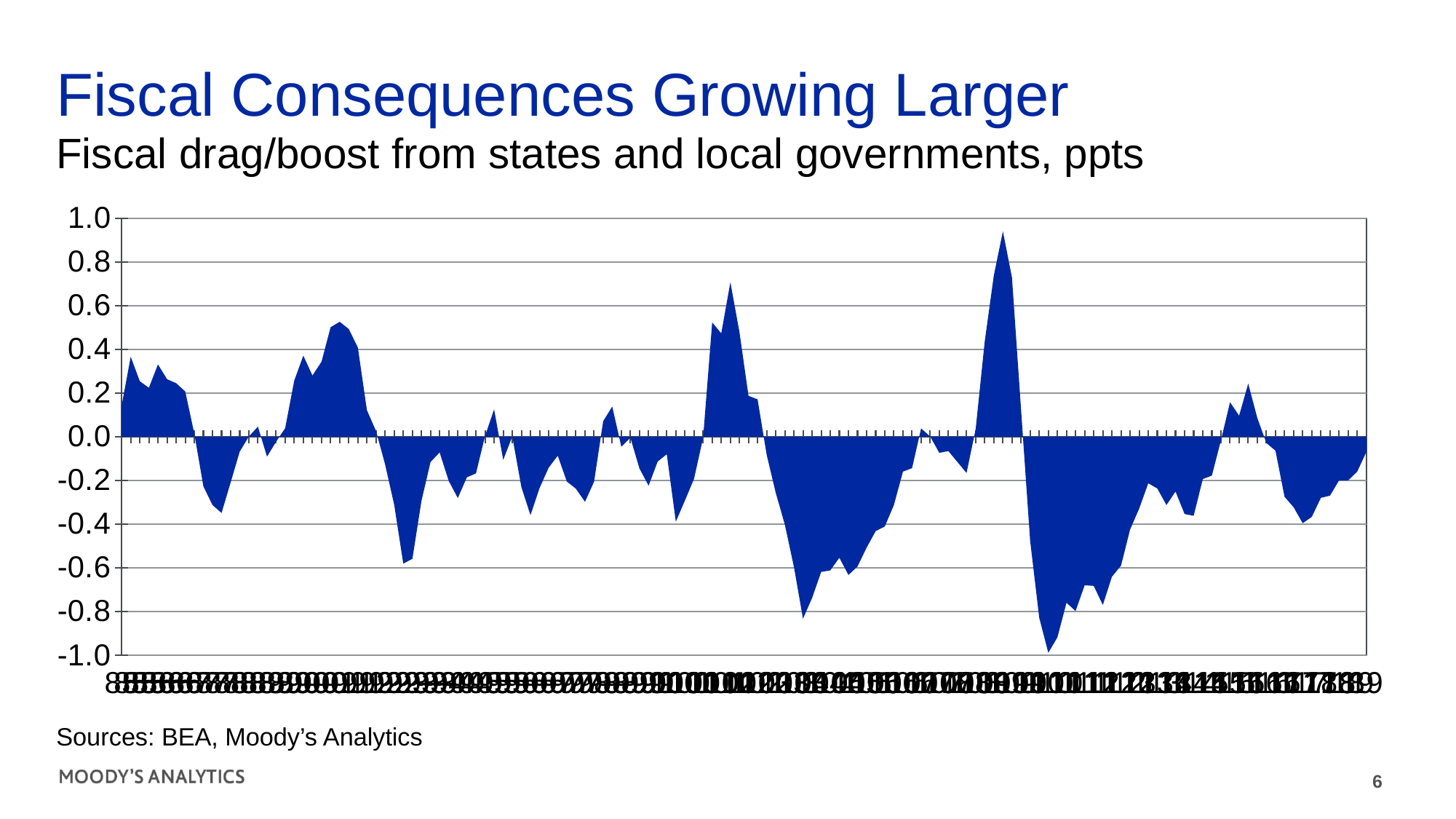
What is the highest tick value shown on the vertical axis? 1.0 What is the lowest tick value shown on the vertical axis? -1.0 What sources are cited for the chart? BEA, Moody's Analytics Is the highest value plotted on the chart greater or less than 0.8? greater What is the subtitle describing the chart's data? Fiscal drag/boost from states and local governments, ppts Is the highest value plotted on the chart greater or less than 1.0? less Is the lowest value plotted on the chart greater or less than -0.8? less What kind of chart is shown on the slide? area chart How many data series are plotted on the chart? 1